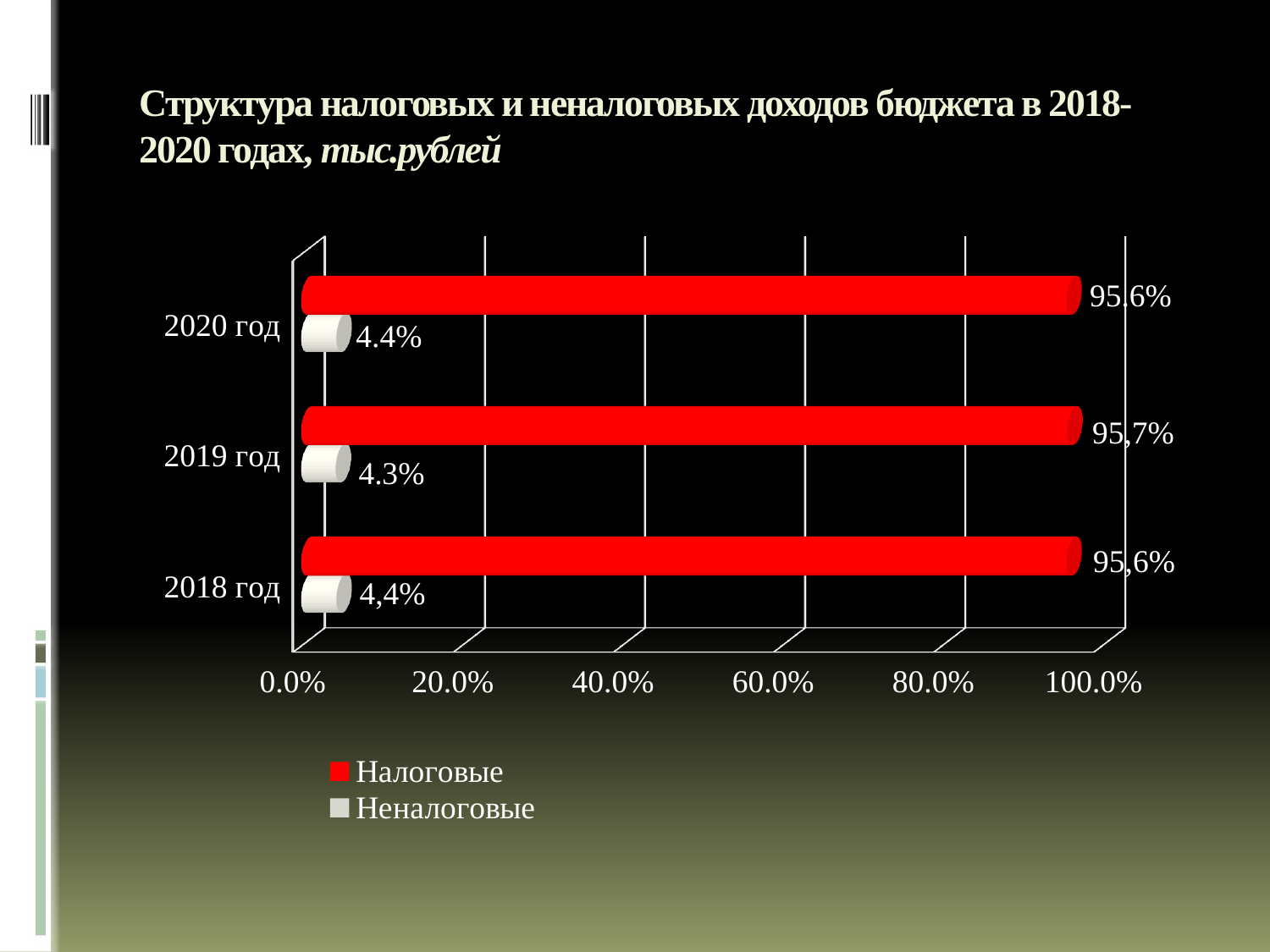
What is the value of Неналоговые for 2019 год? 4.3% In which year is the Налоговые value highest? 2019 год What is the value of Налоговые for 2020 год? 95.6% What is the value of Налоговые for 2018 год? 95,6% What type of chart is shown on the slide? bar chart In which year is the Неналоговые value lowest? 2019 год What is the value of Неналоговые for 2018 год? 4,4% What is the difference between Налоговые and Неналоговые for 2018 год? 91,2% How many year categories are shown on the chart? 3 Which is larger for 2020 год: Налоговые or Неналоговые? Налоговые How many series does the legend list? 2 Which colour represents the Налоговые series? red